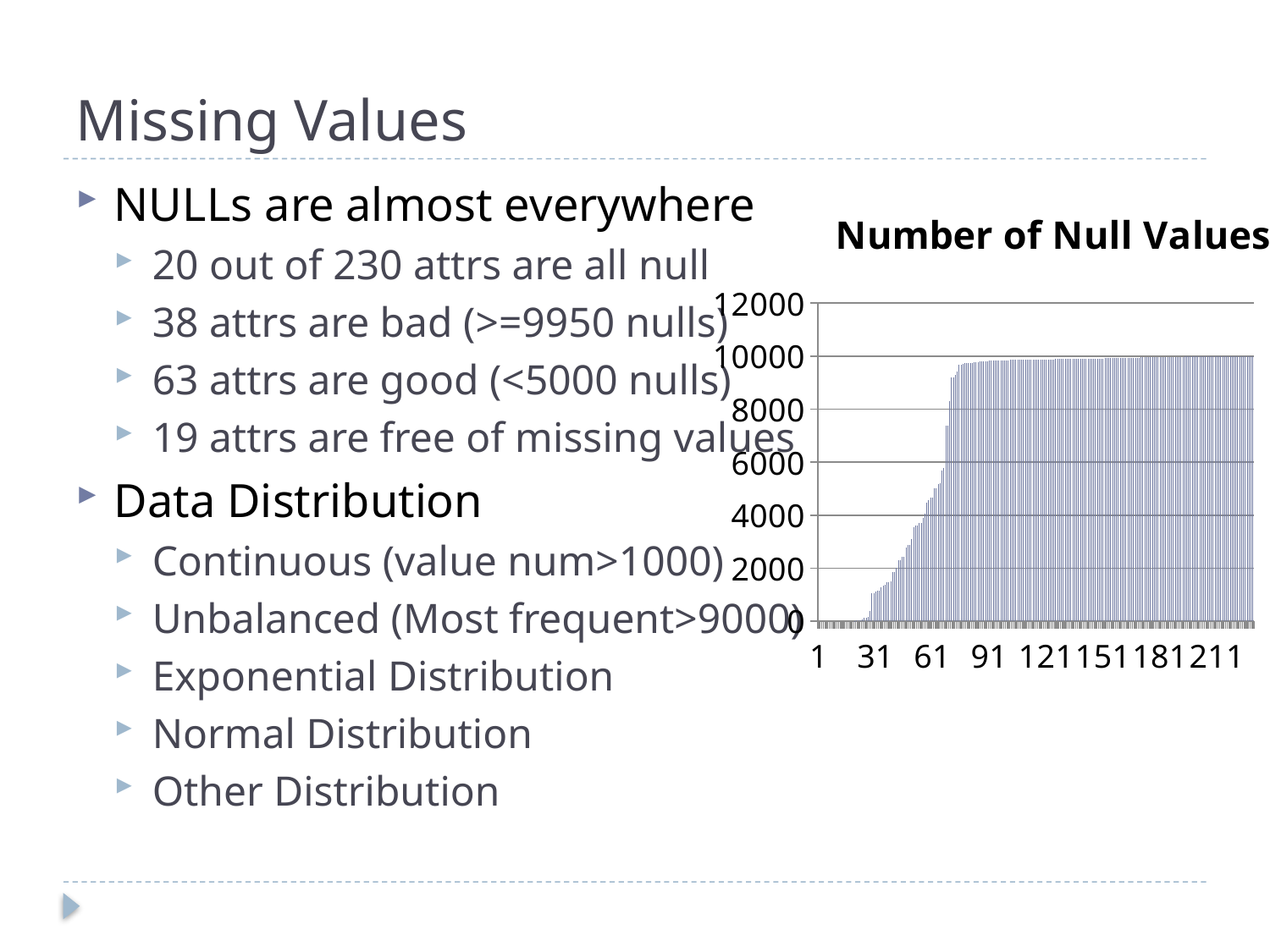
What is the highest value shown on the y axis? 12000 What kind of chart is shown on the slide? bar chart Is the value at x = 1 greater or less than 2000? less How many tick labels are shown on the x axis? 8 Is the value at x = 31 greater or less than 4000? less Which is larger, the value at x = 31 or the value at x = 151? 151 Is the value at x = 61 greater or less than 6000? less Do the values in the chart generally rise or fall from left to right along the x axis? rise What is the title of the chart? Number of Null Values